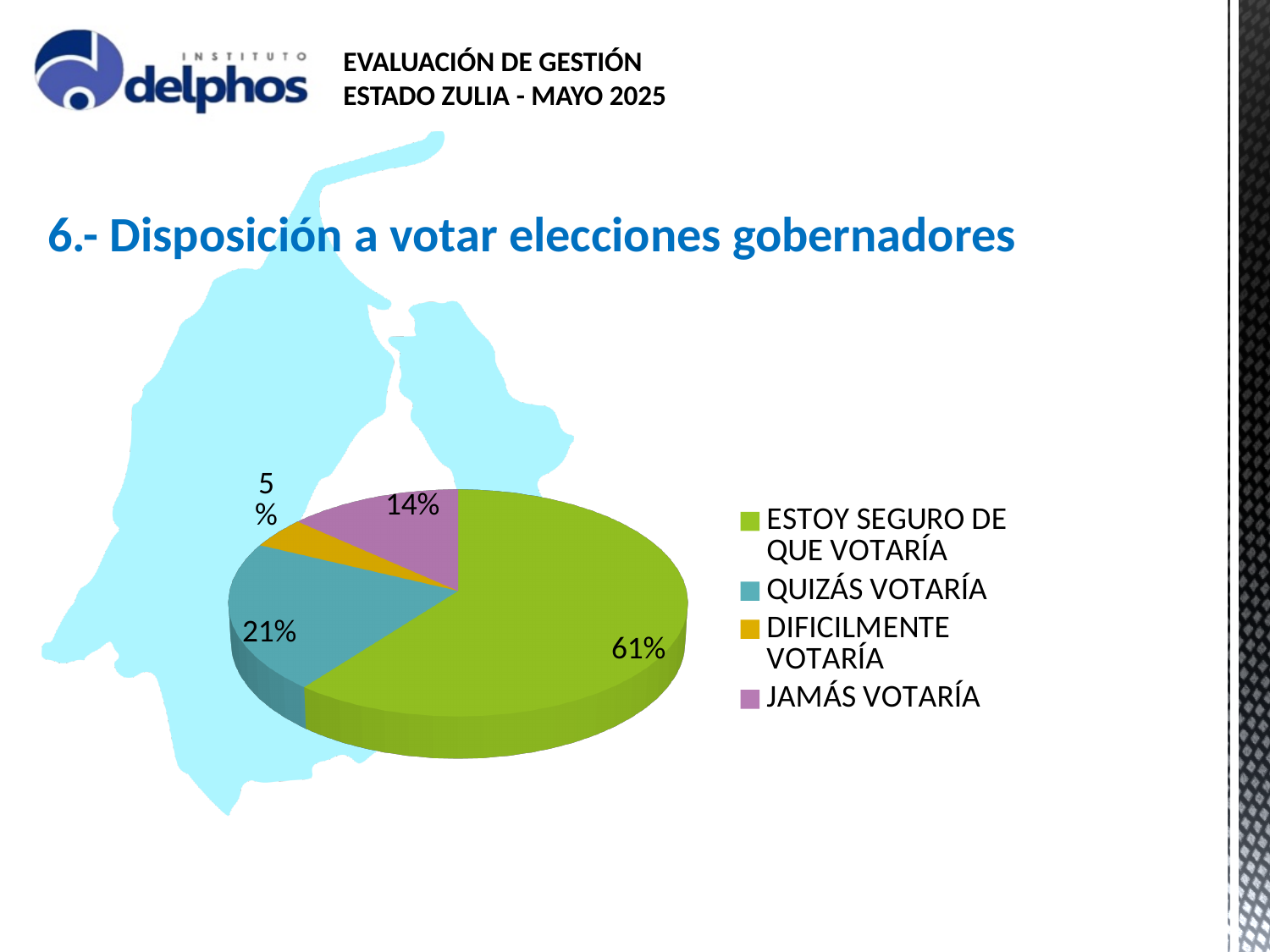
What share of respondents answered "DIFICILMENTE VOTARÍA"? 5% Which response category has the smallest slice of the pie? DIFICILMENTE VOTARÍA What share of respondents answered "QUIZÁS VOTARÍA"? 21% Which is larger, the share for "JAMÁS VOTARÍA" or the share for "QUIZÁS VOTARÍA"? QUIZÁS VOTARÍA Which response category has the largest slice of the pie? ESTOY SEGURO DE QUE VOTARÍA What kind of chart is shown on the slide? Pie chart What is the difference in percentage points between "ESTOY SEGURO DE QUE VOTARÍA" and "QUIZÁS VOTARÍA"? 40 How many categories does the pie chart show? 4 What colour is the slice for "JAMÁS VOTARÍA"? Purple What share of respondents answered "JAMÁS VOTARÍA"? 14% What share of respondents answered "ESTOY SEGURO DE QUE VOTARÍA"? 61% What is the title of the chart on the slide? 6.- Disposición a votar elecciones gobernadores